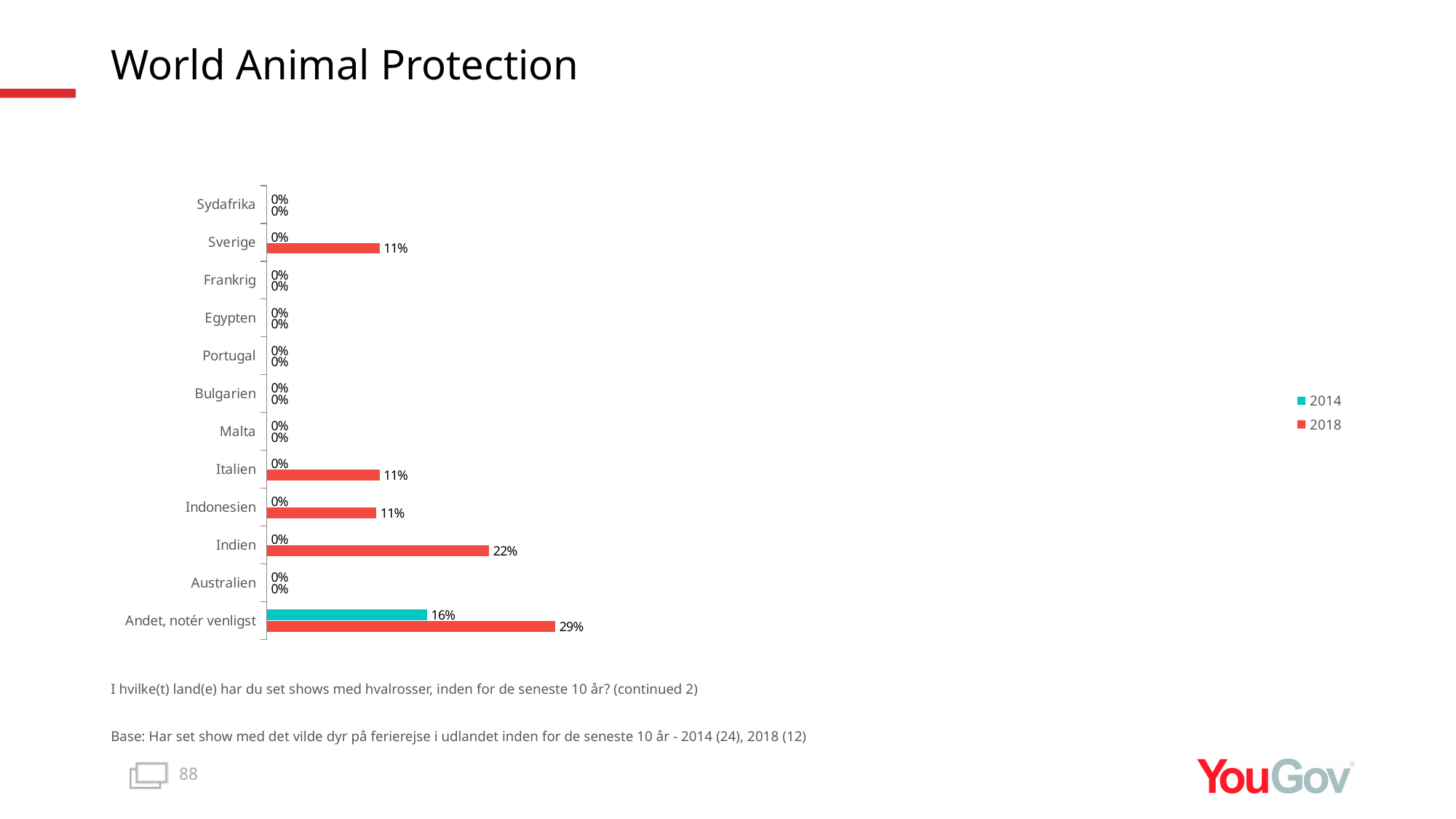
What is the 2014 value for Italien? 0% Which category has the highest 2018 value? Andet, notér venligst What is the 2014 value for Andet, notér venligst? 16% Which series is shown in red in the legend? 2018 What is the 2018 value for Sverige? 11% What is the difference between the 2018 and 2014 values for Andet, notér venligst? 13% What kind of chart is shown on the slide? Bar chart How many categories are shown on the chart? 12 How many series does the legend list? 2 What is the 2018 value for Indien? 22% What is the difference between the 2018 values for Indien and Indonesien? 11% Which is larger: the 2018 value for Indien or the 2018 value for Italien? Indien